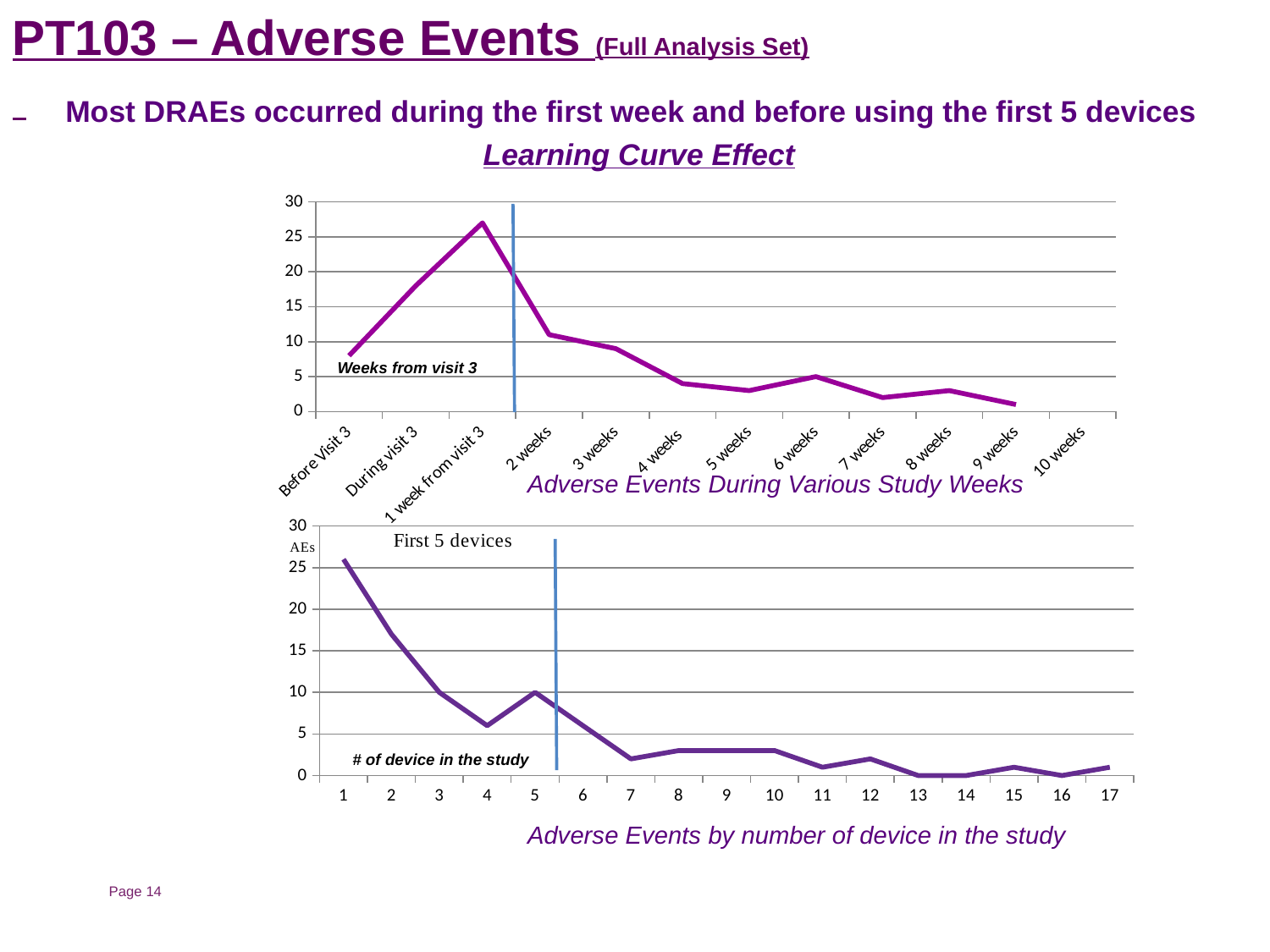
What label is shown next to the vertical blue line in the bottom chart, 'Adverse Events by number of device in the study'? First 5 devices In the top chart, 'Adverse Events During Various Study Weeks', is the value for '1 week from visit 3' greater or less than 25? greater In the bottom chart, 'Adverse Events by number of device in the study', is the value for device 1 greater or less than 25? greater In the top chart, 'Adverse Events During Various Study Weeks', which is larger, the value for '2 weeks' or the value for '4 weeks'? 2 weeks In the bottom chart, 'Adverse Events by number of device in the study', do the values generally rise or fall as the device number increases from 1 to 17? Fall What kind of chart is the top chart, 'Adverse Events During Various Study Weeks'? Line chart In the bottom chart, 'Adverse Events by number of device in the study', which is larger, the value for device 4 or the value for device 5? Device 5 How many categories are shown on the x axis of the top chart, 'Adverse Events During Various Study Weeks'? 12 In the top chart, 'Adverse Events During Various Study Weeks', is the value for 'During visit 3' greater or less than 15? greater In the bottom chart, 'Adverse Events by number of device in the study', which device number has the highest number of adverse events? 1 In the top chart, 'Adverse Events During Various Study Weeks', which category has the highest number of adverse events? 1 week from visit 3